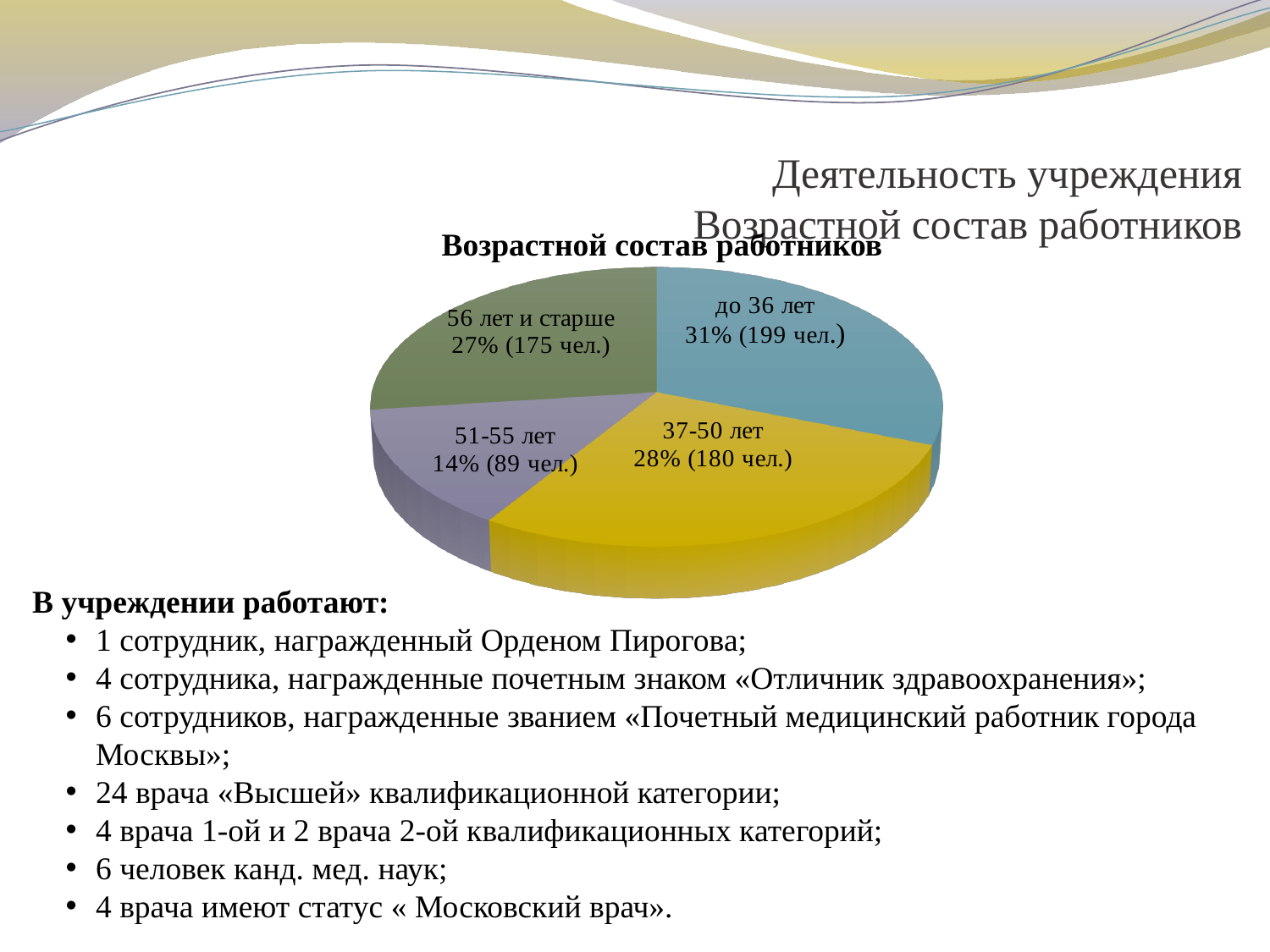
How many slices does the pie chart have? 4 What share of the pie does the "56 лет и старше" slice represent? 27% What share of the pie does the "до 36 лет" slice represent? 31% What is the total number of workers across all four age groups? 643 Which age group has the largest share of workers? до 36 лет What is the title of the chart? Возрастной состав работников How many people are in the "51-55 лет" group? 89 чел. How many more people are in the "до 36 лет" group than in the "51-55 лет" group? 110 Which group has more people: "37-50 лет" or "56 лет и старше"? 37-50 лет Which age group has the smallest share of workers? 51-55 лет How many people are in the "37-50 лет" group? 180 чел. What kind of chart is shown on the slide? pie chart